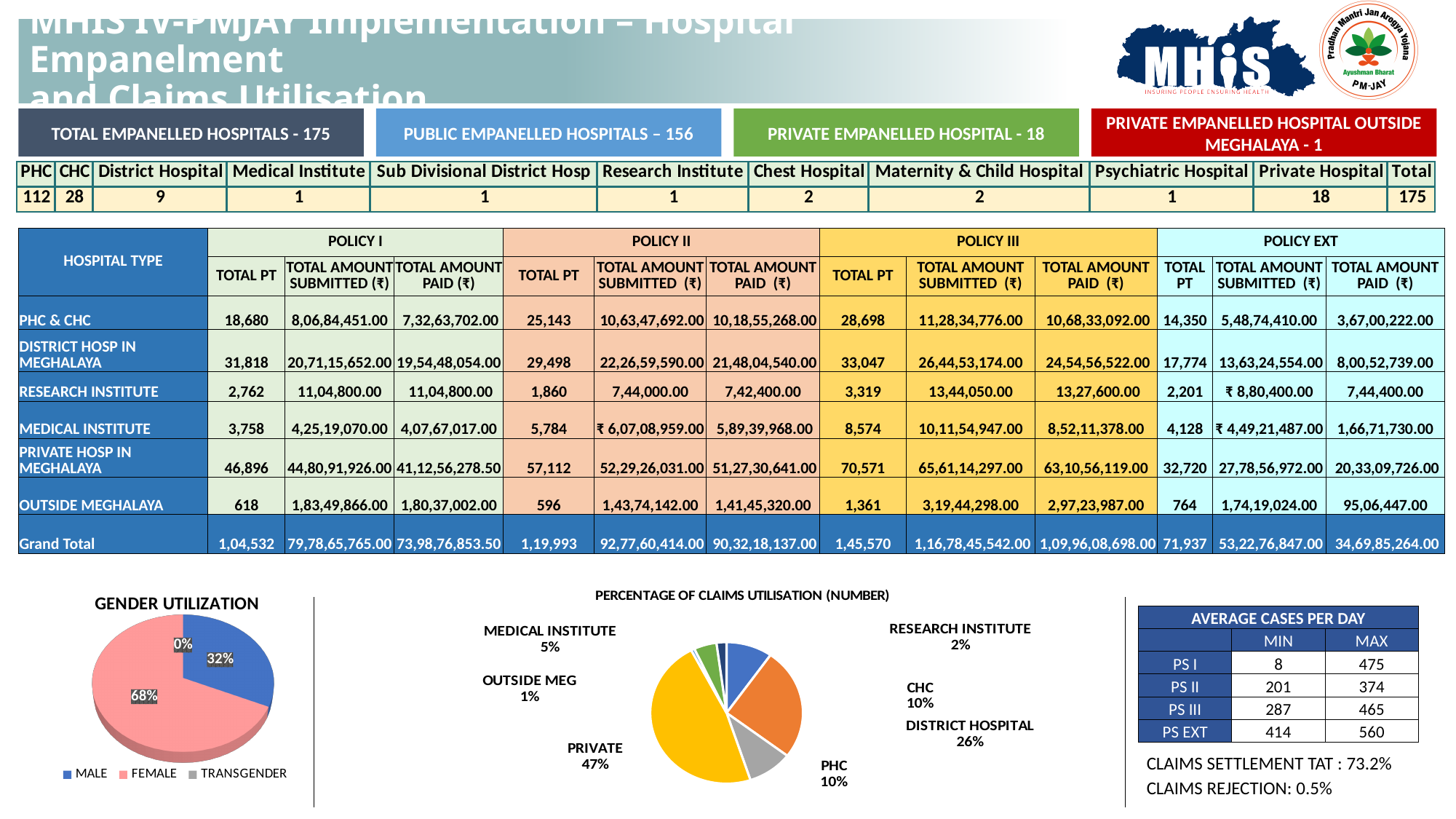
In the PERCENTAGE OF CLAIMS UTILISATION (NUMBER) chart, which is larger, MEDICAL INSTITUTE or RESEARCH INSTITUTE? MEDICAL INSTITUTE What kind of chart is the GENDER UTILIZATION chart? Pie chart In the GENDER UTILIZATION chart, what share of utilization is FEMALE? 68% In the PERCENTAGE OF CLAIMS UTILISATION (NUMBER) chart, what is the share for DISTRICT HOSPITAL? 26% In the PERCENTAGE OF CLAIMS UTILISATION (NUMBER) chart, what is the difference between the PRIVATE and DISTRICT HOSPITAL shares? 21% In the GENDER UTILIZATION chart, how many categories does the legend list? 3 In the GENDER UTILIZATION chart, what share of utilization is MALE? 32% In the GENDER UTILIZATION chart, which gender has the largest share? FEMALE In the PERCENTAGE OF CLAIMS UTILISATION (NUMBER) chart, what is the share for PRIVATE? 47% In the PERCENTAGE OF CLAIMS UTILISATION (NUMBER) chart, which category has the smallest share? OUTSIDE MEG In the PERCENTAGE OF CLAIMS UTILISATION (NUMBER) chart, how many categories are shown? 7 In the GENDER UTILIZATION chart, what is the difference between the FEMALE and MALE shares? 36%